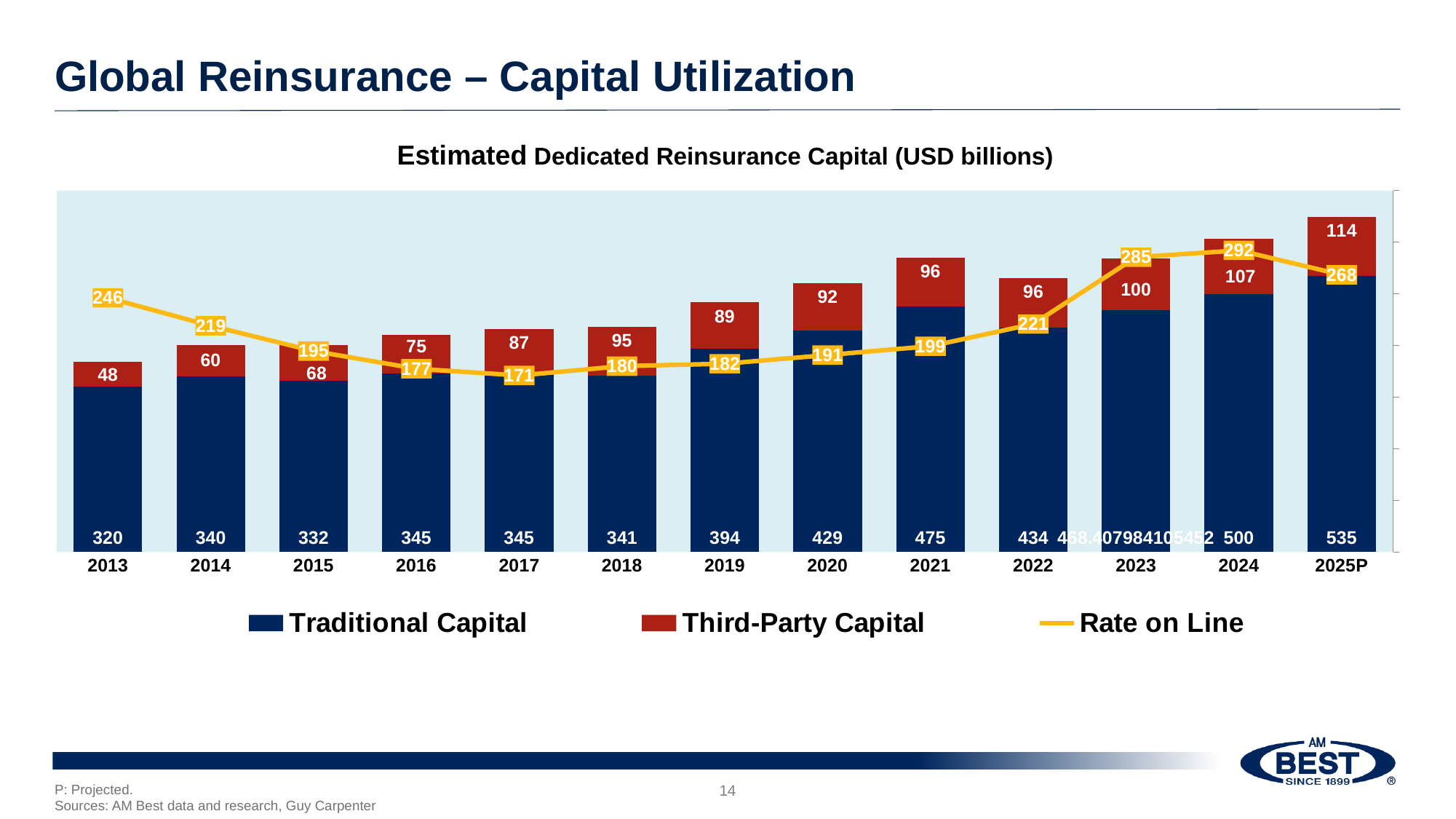
Does the Rate on Line value rise or fall from 2013 to 2017? fall Which is larger, the Rate on Line value for 2017 or for 2022? 2022 What kind of chart is this? Stacked bar chart with a line How many series does the legend list? 3 What is the Rate on Line value for 2013? 246 Which year has the highest Rate on Line value? 2024 What is the total of the stacked bar for 2024 (Traditional Capital plus Third-Party Capital)? 607 How many years are shown on the x axis? 13 What is the difference between the Third-Party Capital values for 2025P and 2013? 66 Which year has the lowest Third-Party Capital value? 2013 What is the Third-Party Capital value for 2017? 87 What is the Traditional Capital value for 2025P? 535